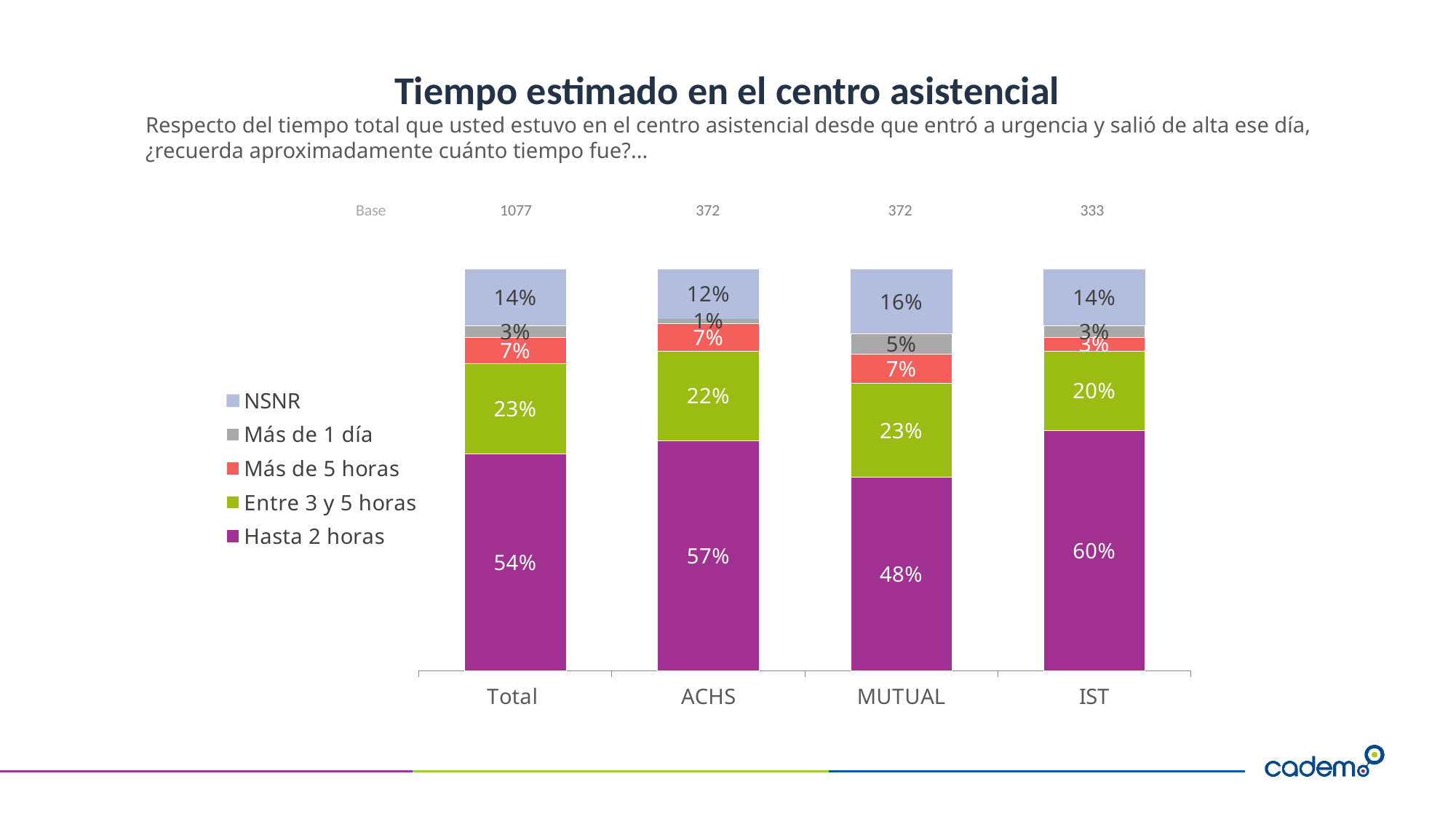
What is the difference between the "Hasta 2 horas" values for IST and MUTUAL? 12 percentage points What kind of chart is shown on the slide? Stacked bar chart What is the value for "Hasta 2 horas" in the MUTUAL bar? 48% Which category has the lowest value for "Hasta 2 horas"? MUTUAL What is the NSNR value for ACHS? 12% What is the base (sample size) shown for IST? 333 Which category has the highest value for "Hasta 2 horas"? IST Which category has the highest NSNR value? MUTUAL How many series does the legend list? 5 How many categories are shown on the x axis? 4 Which is larger, the "Entre 3 y 5 horas" value for Total or for IST? Total What is the value for "Más de 1 día" in the MUTUAL bar? 5%